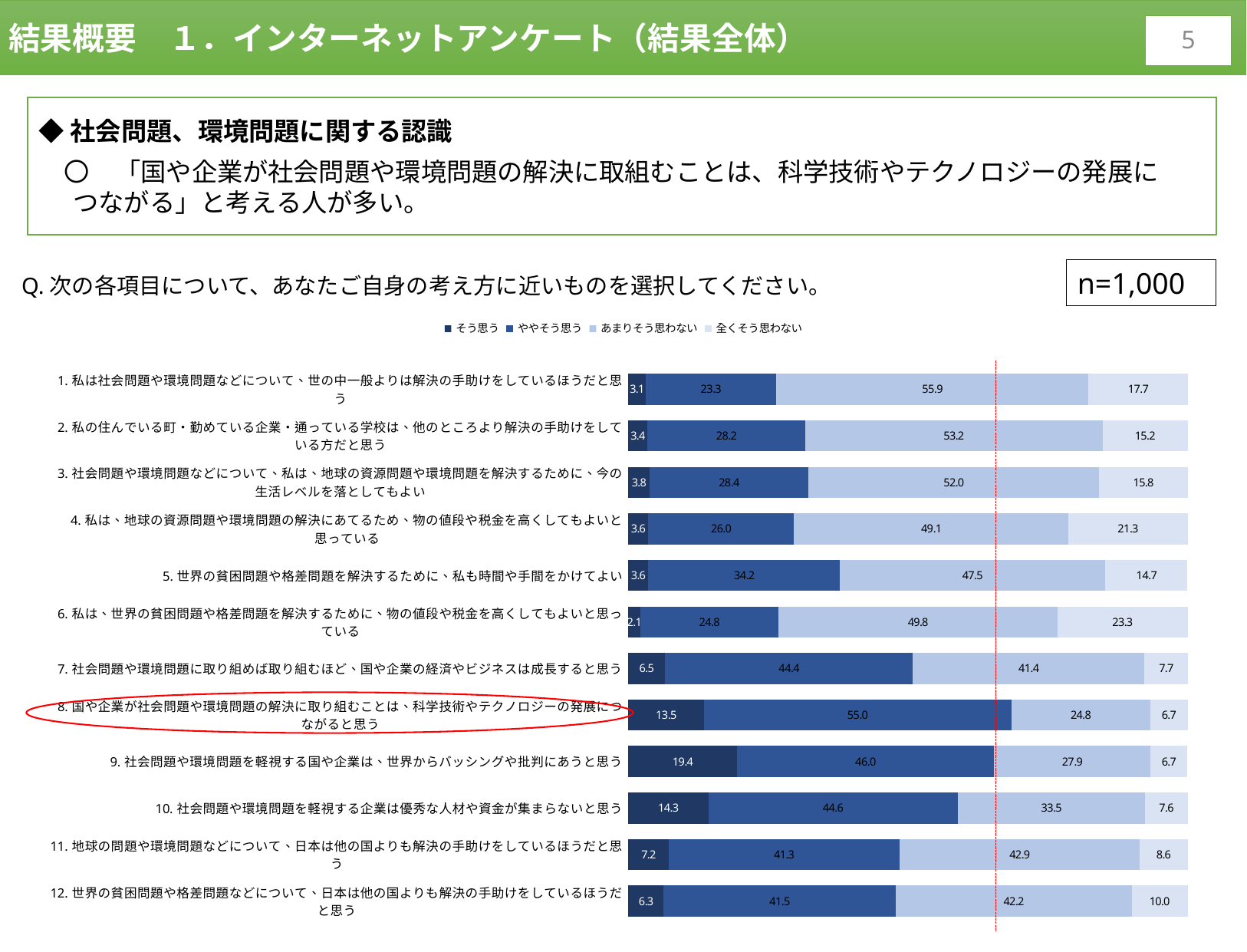
What is the value of そう思う for item 9 (社会問題や環境問題を軽視する国や企業は、世界からバッシングや批判にあうと思う)? 19.4 What is the difference between the ややそう思う values for item 8 and item 7? 10.6 Which item has the highest value for そう思う? 9. 社会問題や環境問題を軽視する国や企業は、世界からバッシングや批判にあうと思う Which item has the highest value for 全くそう思わない? 6. 私は、世界の貧困問題や格差問題を解決するために、物の値段や税金を高くしてもよいと思っている How many series does the legend list? 4 What is the sample size (n) shown on the slide? n=1,000 What is the value of あまりそう思わない for item 1? 55.9 Which has the larger ややそう思う value, item 4 or item 5? Item 5 What kind of chart is shown on the slide? Stacked bar chart What is the value of ややそう思う for item 8 (国や企業が社会問題や環境問題の解決に取り組むことは、科学技術やテクノロジーの発展につながると思う)? 55.0 Which item has the lowest value for そう思う? 6. 私は、世界の貧困問題や格差問題を解決するために、物の値段や税金を高くしてもよいと思っている How many survey items (categories) are plotted in the chart? 12